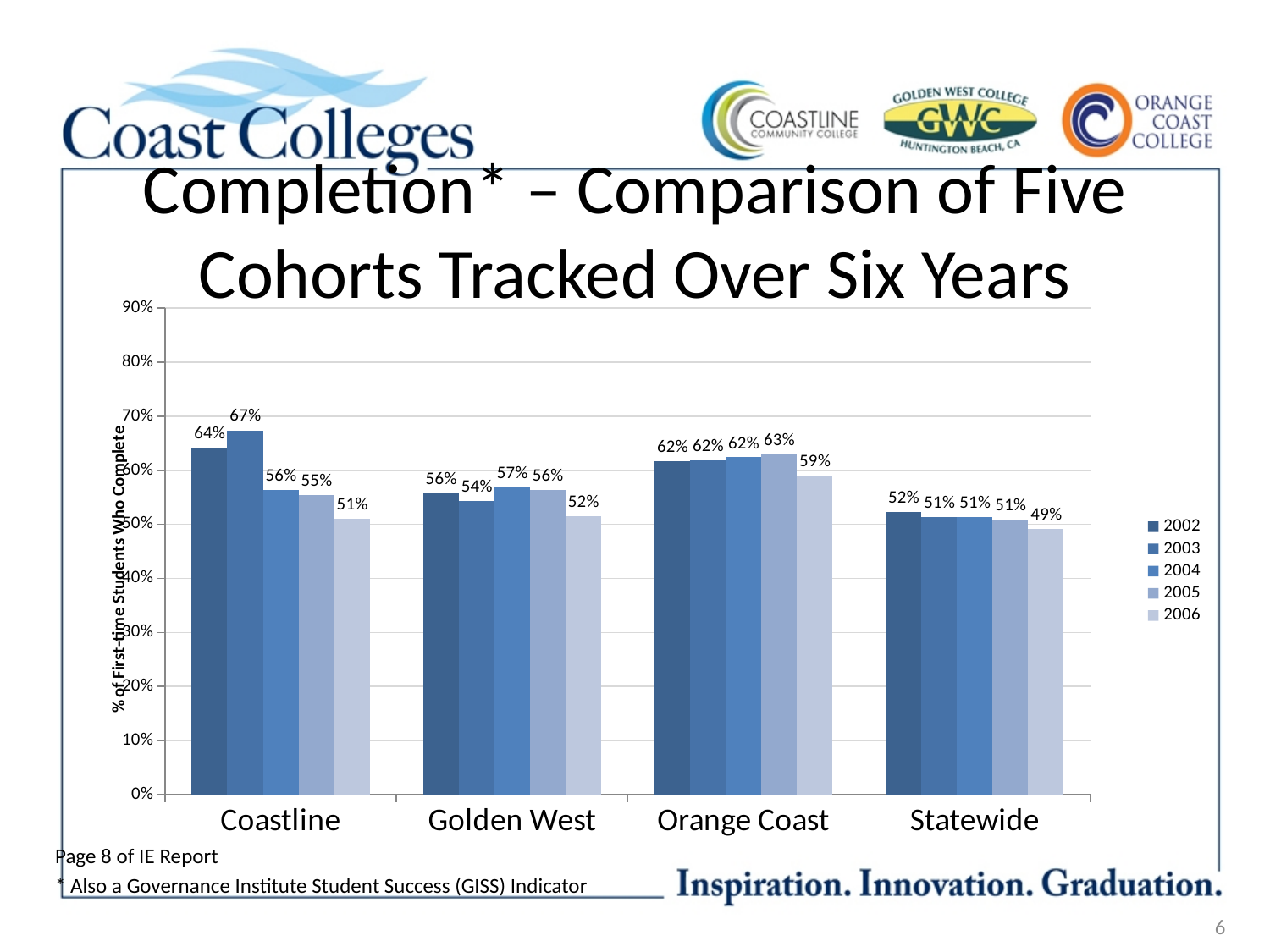
What is the completion rate for the 2006 cohort at Statewide? 49% Which is larger, the 2006 completion rate at Orange Coast or the 2006 completion rate at Coastline? Orange Coast What kind of chart is shown on the slide? Bar chart How many series does the legend list? 5 Which cohort has the highest completion rate at Coastline? 2003 Which cohort has the lowest completion rate at Golden West? 2006 What is the completion rate for the 2003 cohort at Coastline? 67% What is the completion rate for the 2005 cohort at Orange Coast? 63% What is the difference between the 2002 and 2006 completion rates at Coastline? 13% What is the completion rate for the 2004 cohort at Golden West? 57% What is the label of the y axis? % of First-time Students Who Complete How many categories are shown on the x axis? 4